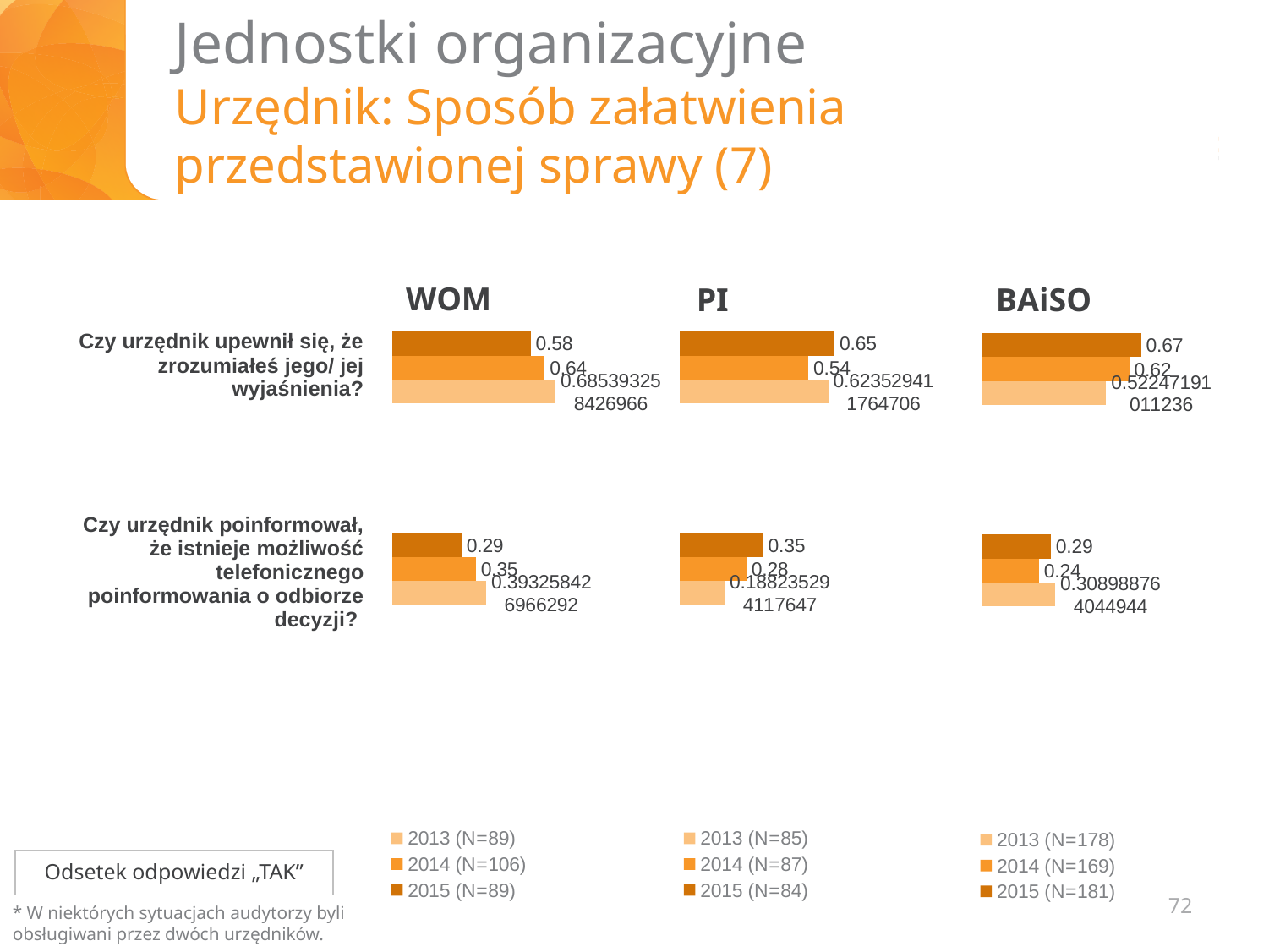
In the PI chart, what is the value for 2015 for the question "Czy urzędnik upewnił się, że zrozumiałeś jego/ jej wyjaśnienia?"? 0.65 In the BAiSO chart, what is the value for 2014 for the question "Czy urzędnik upewnił się, że zrozumiałeś jego/ jej wyjaśnienia?"? 0.62 In the PI chart, what is the value for 2015 for the question about informing of the possibility of telephone notification of the decision? 0.35 What kind of chart is used for the PI data? bar chart In the BAiSO chart, which year has the highest value for the question "Czy urzędnik upewnił się, że zrozumiałeś jego/ jej wyjaśnienia?"? 2015 How many series does the legend of the WOM chart list? 3 In the PI chart, which is larger for the question "Czy urzędnik upewnił się, że zrozumiałeś jego/ jej wyjaśnienia?": the 2015 value or the 2014 value? 2015 In the BAiSO chart, what is the value for 2014 for the question about informing of the possibility of telephone notification of the decision? 0.24 In the WOM chart, what is the difference between the 2014 and 2015 values for the question about informing of the possibility of telephone notification of the decision? 0.06 In the WOM chart, what is the value for 2015 for the question "Czy urzędnik upewnił się, że zrozumiałeś jego/ jej wyjaśnienia?"? 0.58 According to the legend of the BAiSO chart, what is the sample size (N) for 2015? 181 In the WOM chart, what is the difference between the 2014 and 2015 values for the question "Czy urzędnik upewnił się, że zrozumiałeś jego/ jej wyjaśnienia?"? 0.06